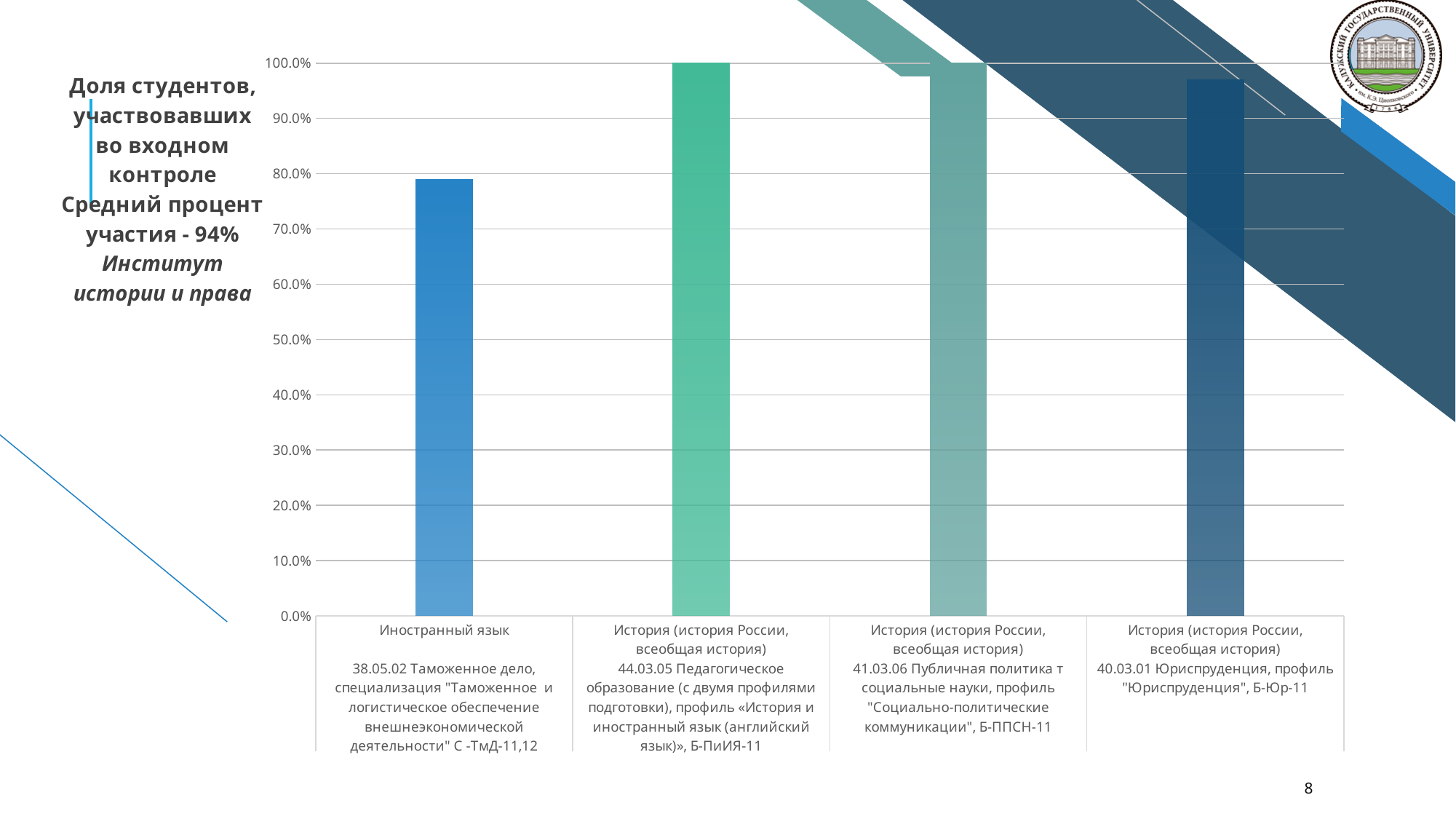
Is the value for Иностранный язык (С-ТмД-11,12) greater or less than 90.0%? less What kind of chart is shown on the slide? bar chart What is the value for the bar labelled Б-ПиИЯ-11 (44.03.05 Педагогическое образование)? 100.0% What is the value for the bar labelled Б-ППСН-11 (41.03.06 Публичная политика и социальные науки)? 100.0% Is the value for Б-Юр-11 (40.03.01 Юриспруденция) greater or less than 90.0%? greater Which is larger: the bar for Иностранный язык (С-ТмД-11,12) or the bar for Б-Юр-11? Б-Юр-11 Which institute does the slide's chart refer to? Институт истории и права According to the text on the slide, what is the average participation percentage (Средний процент участия)? 94% How many bars (categories) does the chart show? 4 Which is larger: the bar for Иностранный язык (С-ТмД-11,12) or the bar for Б-ПиИЯ-11? Б-ПиИЯ-11 Is the value for Иностранный язык (С-ТмД-11,12) greater or less than 70.0%? greater Which category has the lowest bar? Иностранный язык (38.05.02 Таможенное дело, С-ТмД-11,12)